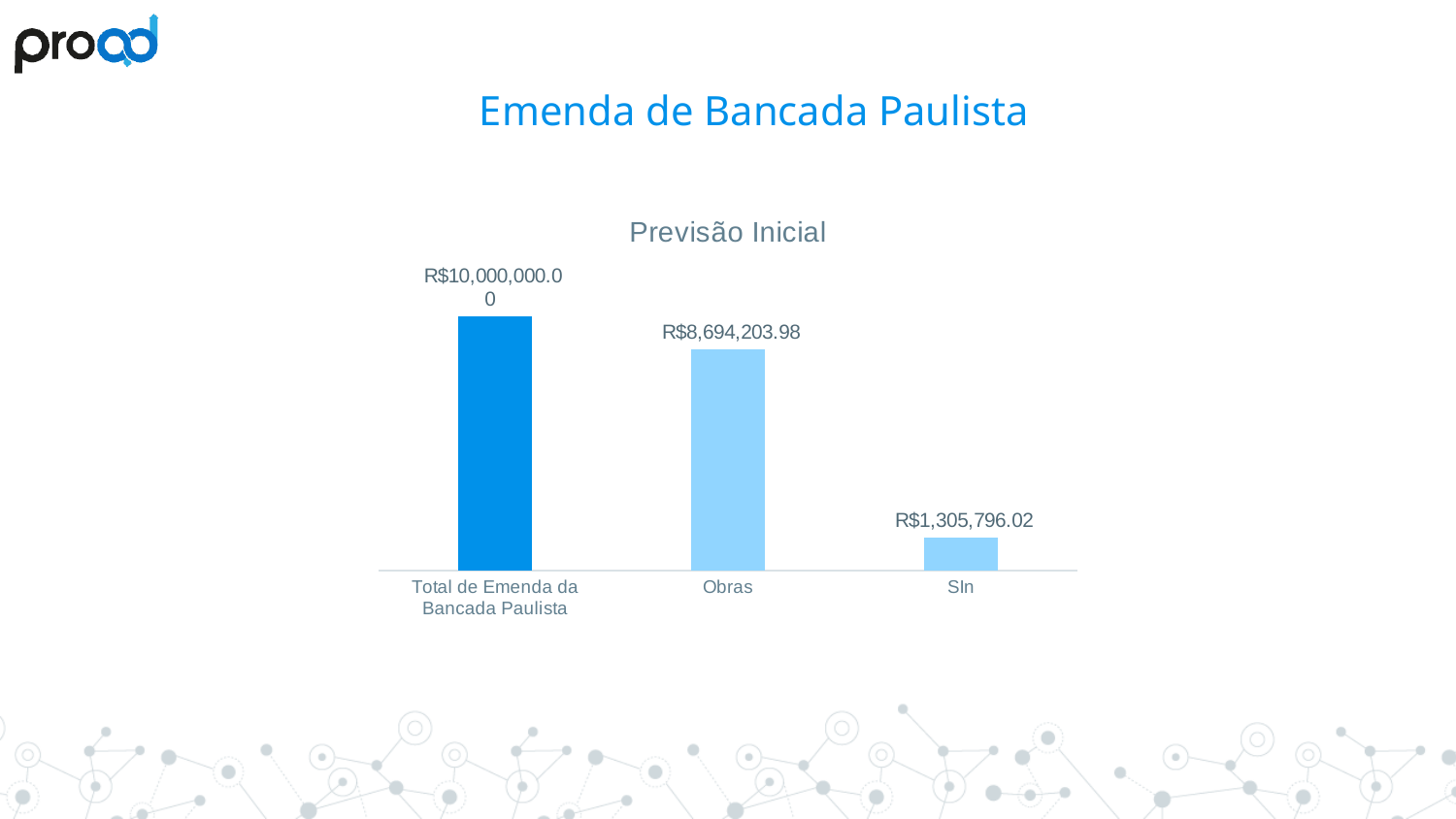
Do the values rise or fall from left to right across the categories? Fall What is the difference between the value for Total de Emenda da Bancada Paulista and the value for Obras? R$1,305,796.02 Which category has the highest value? Total de Emenda da Bancada Paulista What is the value for Obras? R$8,694,203.98 What is the value for SIn? R$1,305,796.02 How many categories are shown in the chart? 3 What is the difference between the value for Obras and the value for SIn? R$7,388,407.96 What is the title of the chart? Previsão Inicial Which is larger, the value for Obras or the value for SIn? Obras Which category has the lowest value? SIn What is the value for Total de Emenda da Bancada Paulista? R$10,000,000.00 What kind of chart is shown on the slide? Bar chart